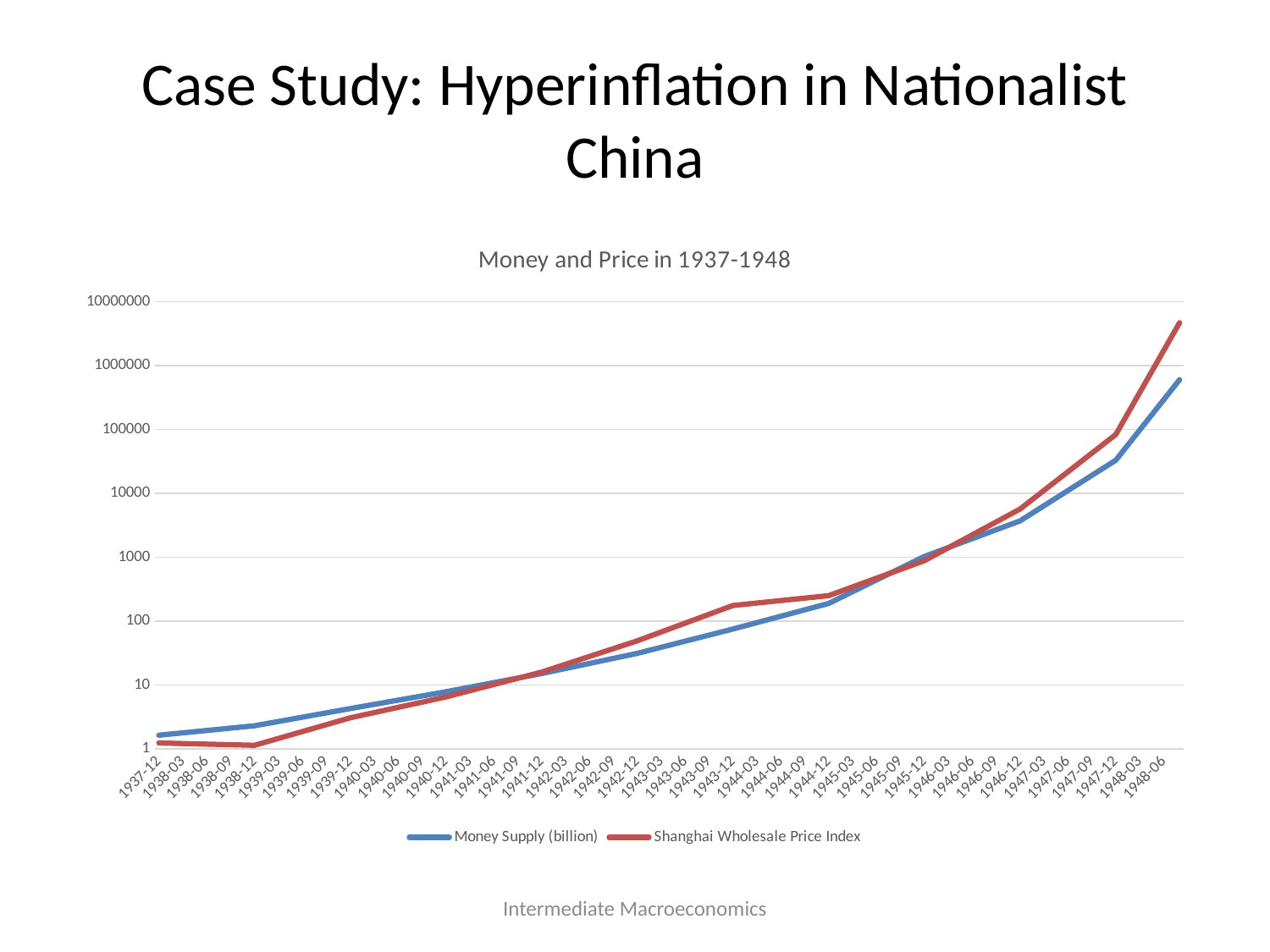
Which series is drawn in red? Shanghai Wholesale Price Index What kind of chart is shown on the slide? line chart Do the values of the Money Supply (billion) series rise or fall from 1937-12 to 1948-06? rise Is the Shanghai Wholesale Price Index at 1948-06 greater or less than 1000000? greater Is the Money Supply (billion) at 1943-12 greater or less than 100? less At 1948-06, which series has the higher value, Money Supply (billion) or Shanghai Wholesale Price Index? Shanghai Wholesale Price Index At 1938-12, which series has the higher value, Money Supply (billion) or Shanghai Wholesale Price Index? Money Supply (billion) What is the title of the chart? Money and Price in 1937-1948 How many time points are labelled on the x axis? 43 How many series does the legend list? 2 Is the Money Supply (billion) at 1948-06 greater or less than 1000000? less